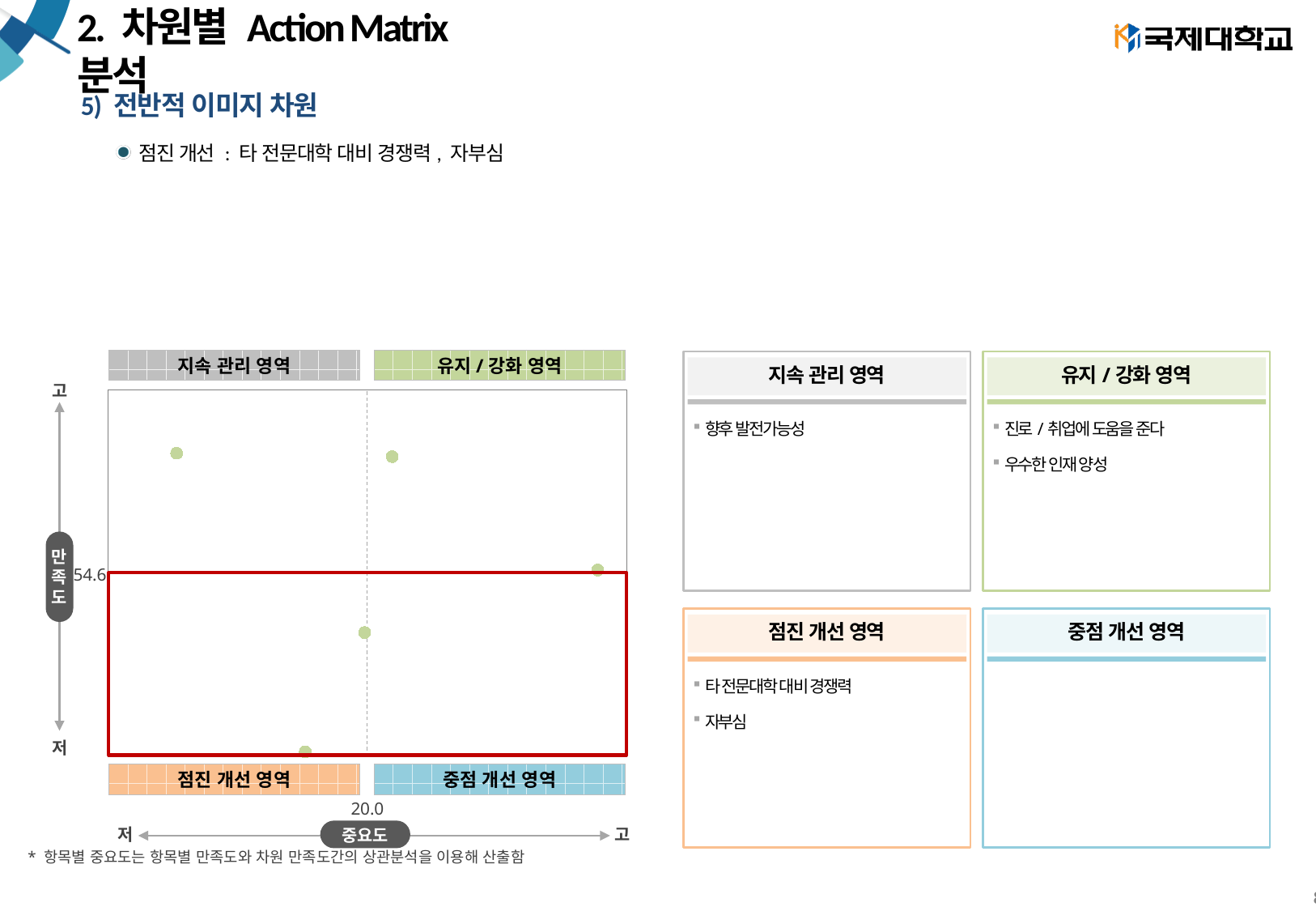
What 만족도 value is marked by the horizontal reference line on the chart? 54.6 What kind of chart is shown on the left of the slide? scatter chart How many data points are plotted on the action matrix chart? 5 Is the leftmost data point on the chart above or below the 54.6 만족도 line? above Is the leftmost data point on the chart to the left or right of the 20.0 중요도 line? left What 중요도 value is marked by the vertical dashed reference line on the chart? 20.0 How many data points fall in the 지속 관리 영역 (upper-left) quadrant of the chart? 1 Is the lowest data point on the chart to the left or right of the 20.0 중요도 line? left